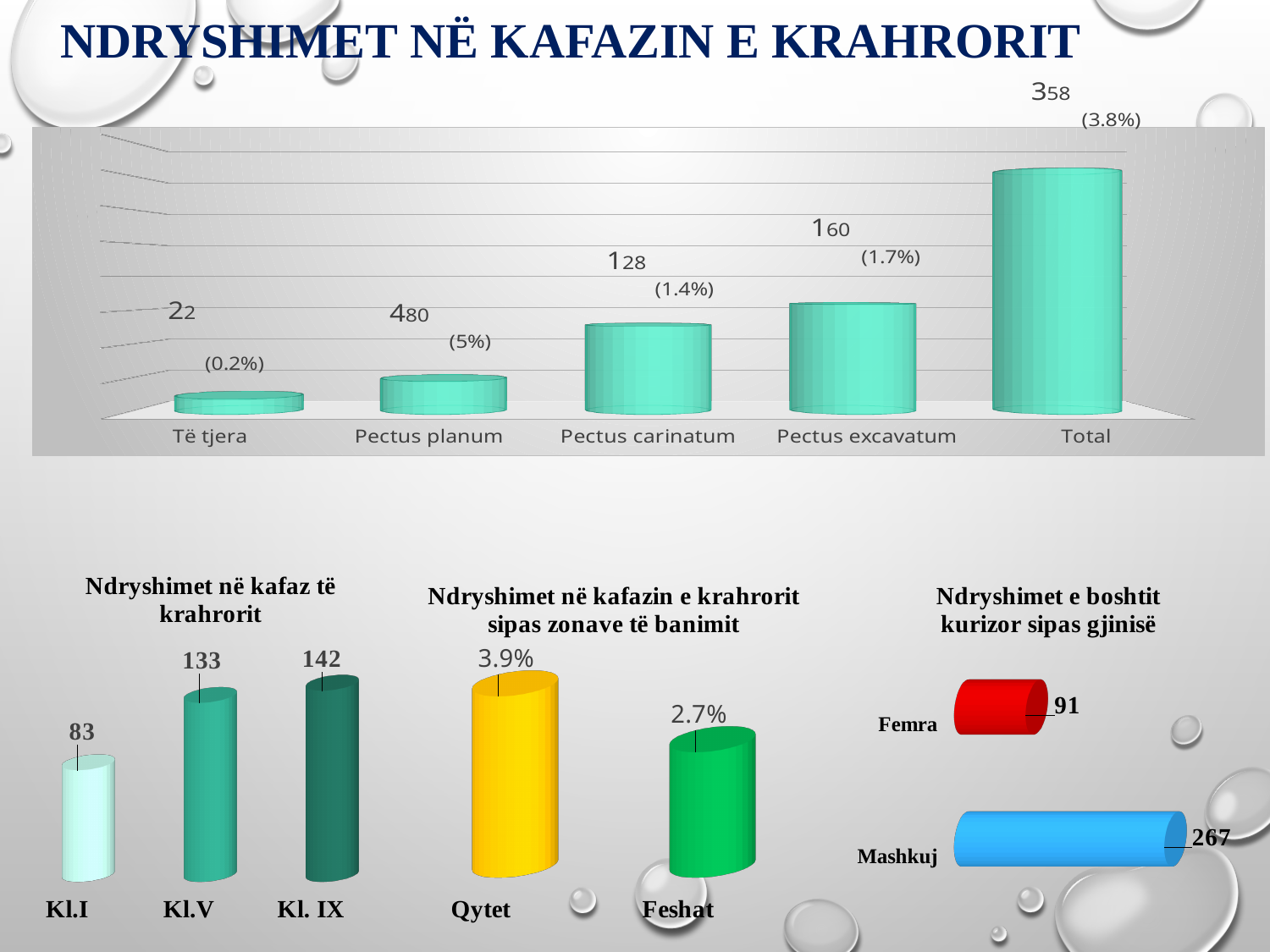
In the bottom-right chart 'Ndryshimet e boshtit kurizor sipas gjinisë', what is the difference between Mashkuj and Femra? 176 In the bottom-right chart 'Ndryshimet e boshtit kurizor sipas gjinisë', what kind of chart is it? Bar chart In the top chart, what percentage is shown for Pectus excavatum? (1.7%) In the bottom-left chart 'Ndryshimet në kafaz të krahrorit', what is the difference between Kl. IX and Kl.I? 59 In the bottom-left chart 'Ndryshimet në kafaz të krahrorit', what is the value for Kl.V? 133 In the bottom-left chart 'Ndryshimet në kafaz të krahrorit', how many categories are shown? 3 In the bottom-middle chart 'Ndryshimet në kafazin e krahrorit sipas zonave të banimit', which is larger, Qytet or Feshat? Qytet In the top chart, what is the value for Total? 358 In the bottom-middle chart 'Ndryshimet në kafazin e krahrorit sipas zonave të banimit', what is the value for Qytet? 3.9% In the top chart, which category has the lowest value? Të tjera In the bottom-right chart 'Ndryshimet e boshtit kurizor sipas gjinisë', what is the value for Mashkuj? 267 In the bottom-left chart 'Ndryshimet në kafaz të krahrorit', which class has the highest value? Kl. IX